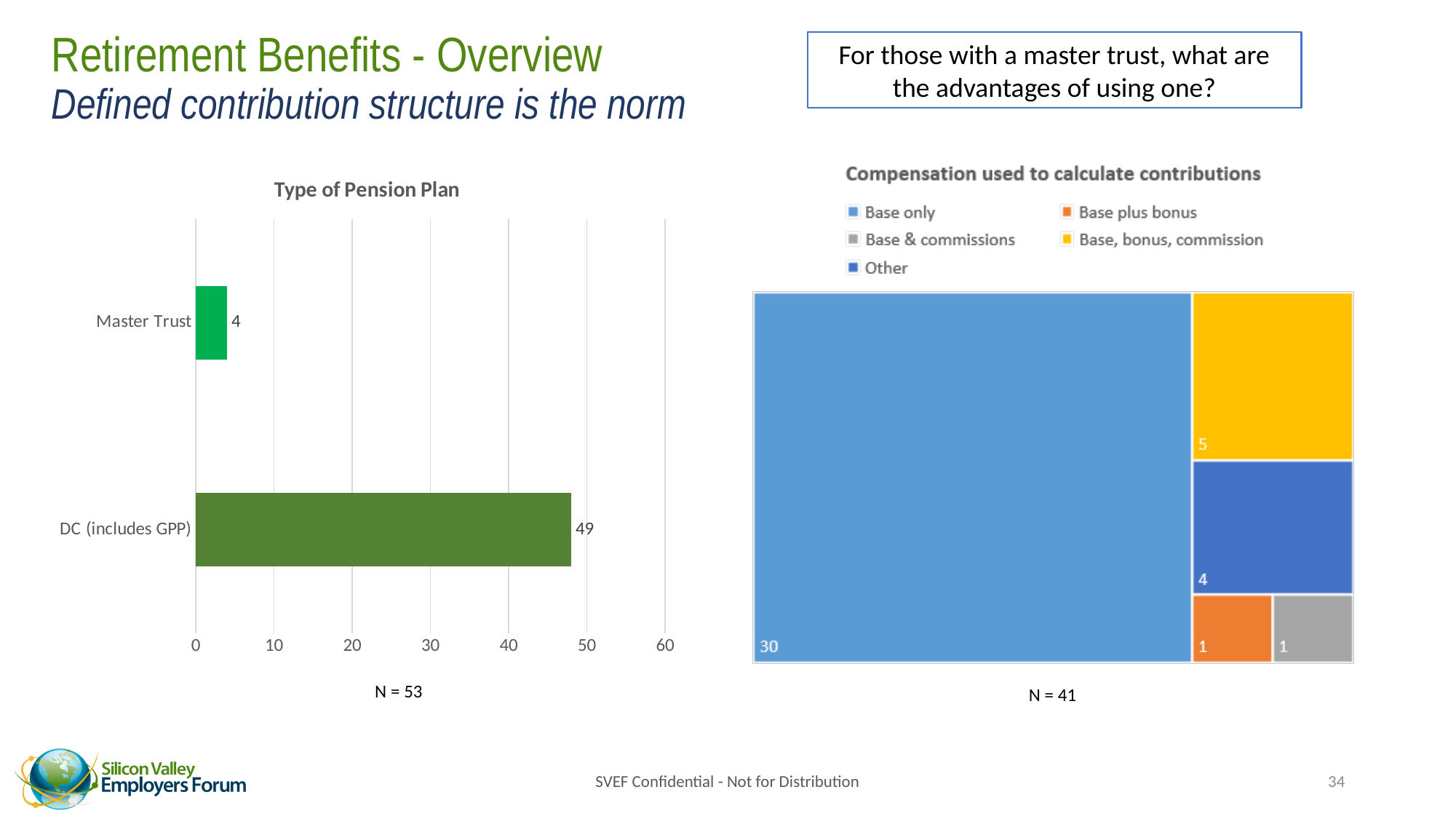
What kind of chart is the 'Type of Pension Plan' chart? Bar chart In the 'Compensation used to calculate contributions' chart, what is the value for Base, bonus, commission? 5 In the 'Type of Pension Plan' chart, what is the value for Master Trust? 4 In the 'Type of Pension Plan' chart, what is the difference between the DC (includes GPP) value and the Master Trust value? 45 In the 'Type of Pension Plan' chart, what is the value for DC (includes GPP)? 49 In the 'Type of Pension Plan' chart, which category has the highest value? DC (includes GPP) In the 'Compensation used to calculate contributions' chart, which category has the highest value? Base only How many entries does the legend of the 'Compensation used to calculate contributions' chart list? 5 In the 'Compensation used to calculate contributions' chart, what is the value for Base only? 30 In the 'Compensation used to calculate contributions' chart, which is larger: Other or Base plus bonus? Other How many categories does the 'Type of Pension Plan' chart show? 2 In the 'Type of Pension Plan' chart, is the value for DC (includes GPP) greater or less than 40? greater